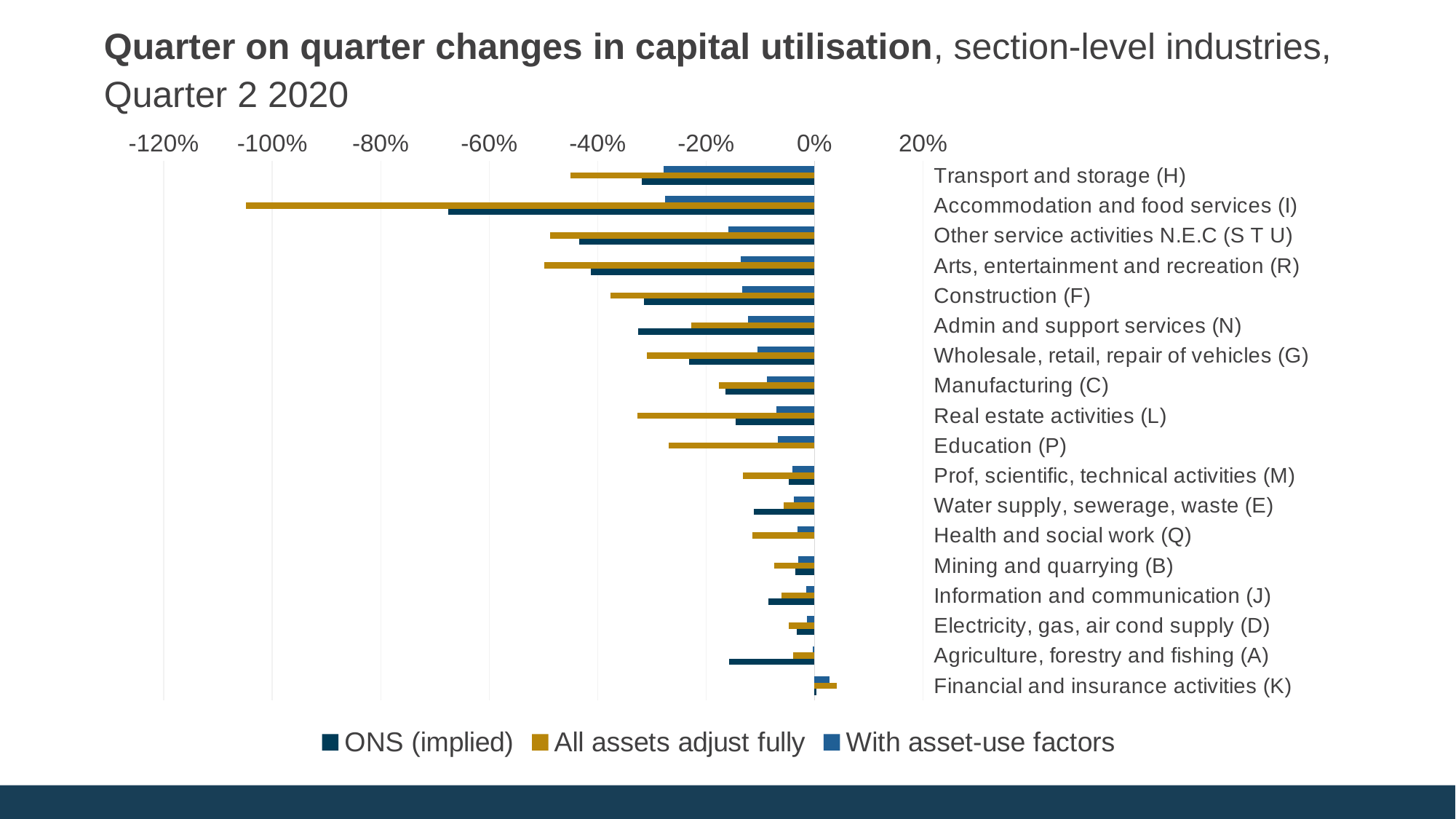
Which industry is the only one with a positive change in capital utilisation? Financial and insurance activities (K) Is the 'With asset-use factors' value for Manufacturing (C) greater or less than -20%? greater Which industry shows the largest decline in the 'ONS (implied)' series? Accommodation and food services (I) Which industry shows the largest decline in the 'All assets adjust fully' series? Accommodation and food services (I) Which has the larger decline in the 'ONS (implied)' series: Accommodation and food services (I) or Transport and storage (H)? Accommodation and food services (I) Which quarter does the chart title say the data refers to? Quarter 2 2020 What kind of chart is shown on the slide? Bar chart Is the 'All assets adjust fully' value for Accommodation and food services (I) greater or less than -100%? less Is the 'ONS (implied)' value for Accommodation and food services (I) greater or less than -60%? less How many industries are plotted on the chart? 18 How many series does the legend list? 3